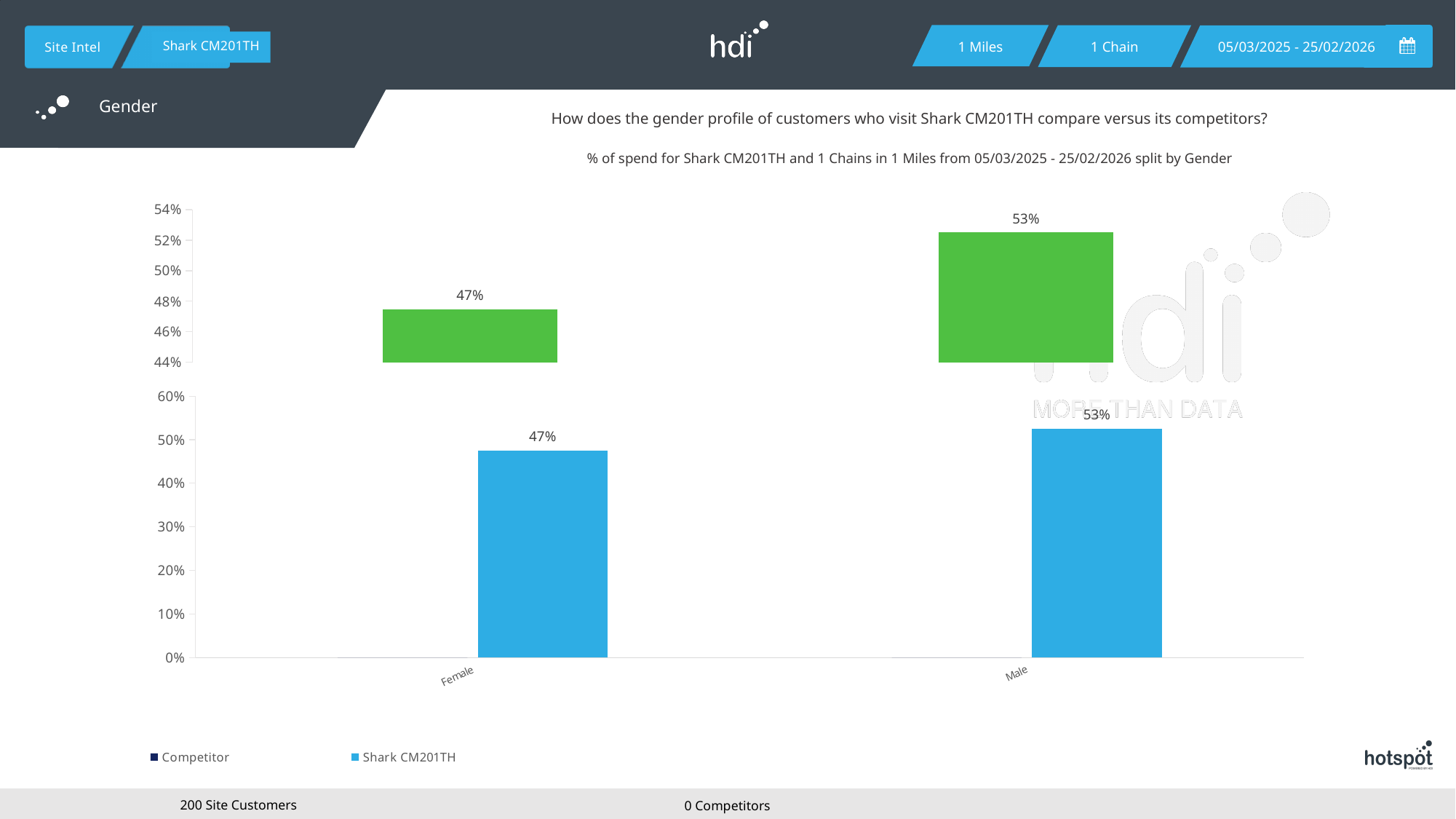
In the upper chart, what is the value for Male? 53% In the lower chart, which category has the highest value? Male How many series does the legend at the bottom of the slide list? 2 In the upper chart, which category has the lowest value? Female In the lower chart, what is the value for Female? 47% In the upper chart, is the value for Male larger or smaller than the value for Female? larger In the upper chart, what is the value for Female? 47% What kind of chart is the lower chart? bar chart In the lower chart, is the value for Female greater or less than 50%? less In the lower chart, what is the difference between the Male and Female values? 6% In the lower chart, what is the value for Male? 53% How many categories are shown on the x axis of the lower chart? 2